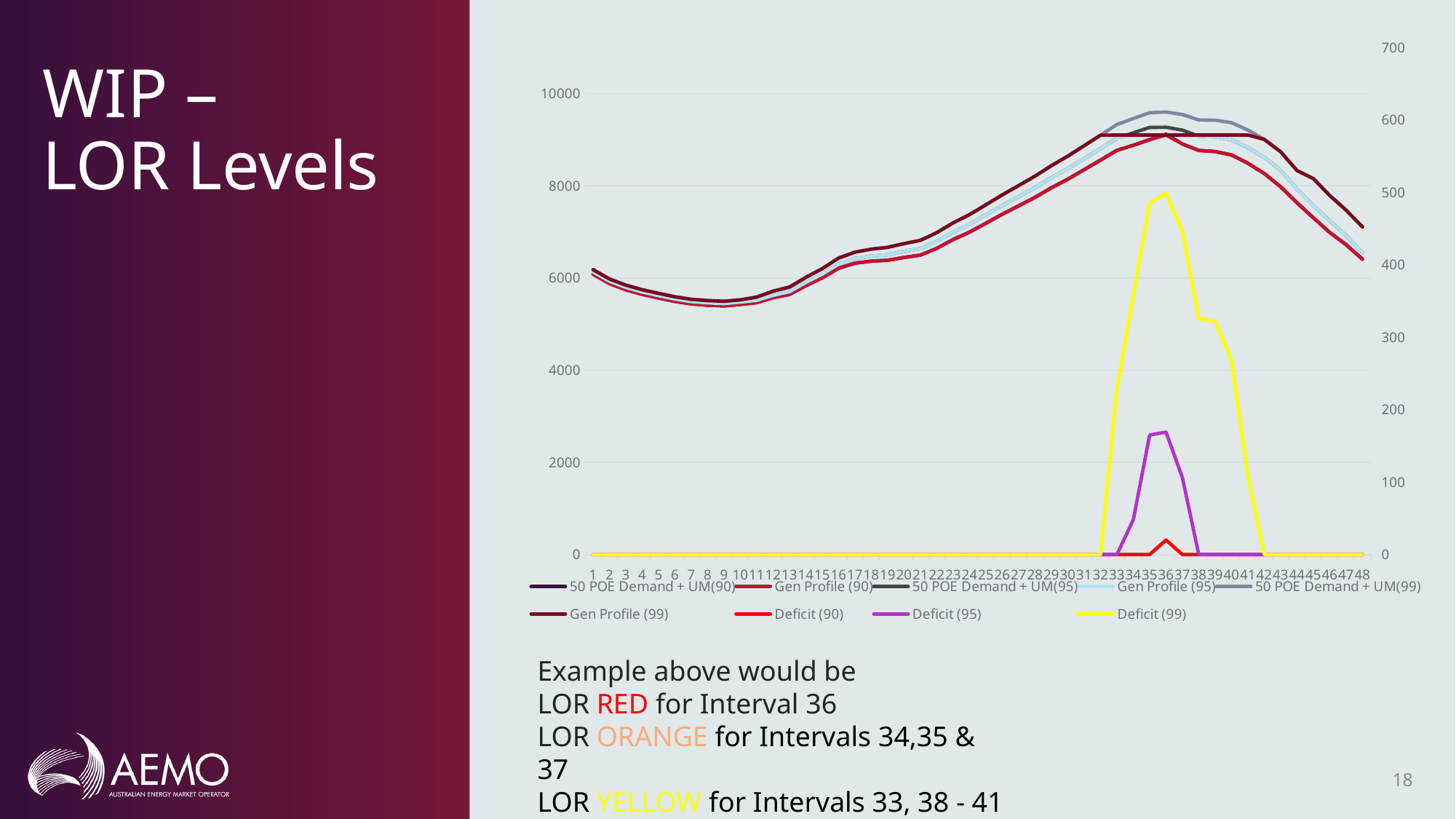
What is the highest tick value shown on the left-hand axis of the chart? 10000 Is the peak value of Deficit (95) on the right-hand axis greater or less than 200? less Do the Gen Profile lines rise or fall from interval 9 to interval 36? rise How many intervals are shown along the x axis of the chart? 48 At interval 36, which is larger, Deficit (99) or Deficit (95)? Deficit (99) Which of the Deficit series reaches the highest peak on the chart? Deficit (99) How many series does the chart's legend list? 9 Is the value of Gen Profile (90) at interval 36 greater or less than 8000 on the left-hand axis? greater Is the peak value of Deficit (99) on the right-hand axis greater or less than 400? greater Which of the Deficit series has the lowest peak on the chart? Deficit (90) What kind of chart is shown on the slide? line chart What colour is the Deficit (99) line on the chart? yellow